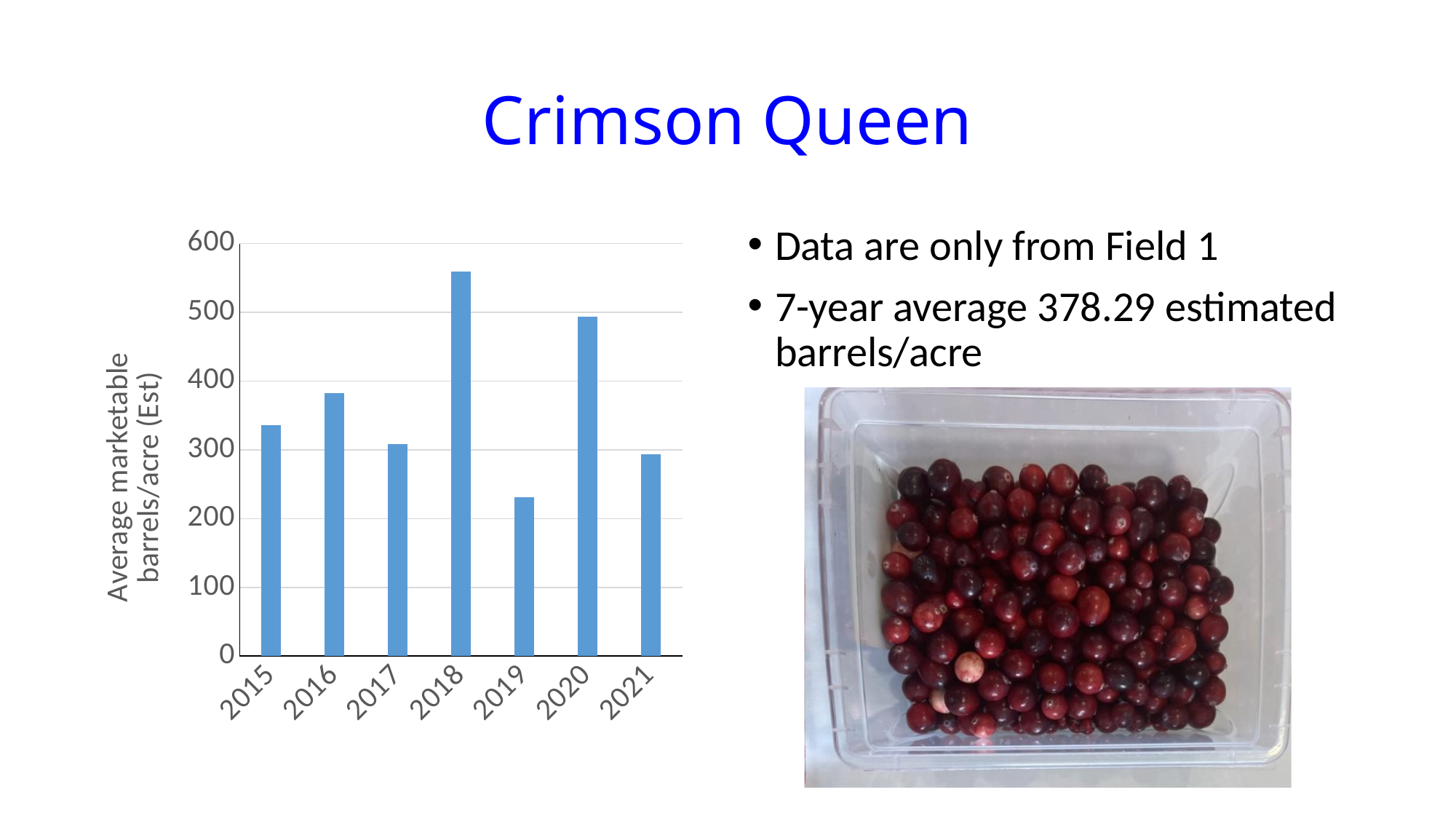
What is the label on the vertical axis of the chart? Average marketable barrels/acre (Est) Which year has the highest average marketable barrels/acre? 2018 How many years are plotted on the chart? 7 Is the value for 2019 greater or less than 300? less What kind of chart is shown on the slide? bar chart Which year has the lowest average marketable barrels/acre? 2019 Which year has the larger value, 2018 or 2020? 2018 Which year has the larger value, 2019 or 2021? 2021 Is the value for 2020 greater or less than 400? greater Is the value for 2016 greater or less than 400? less